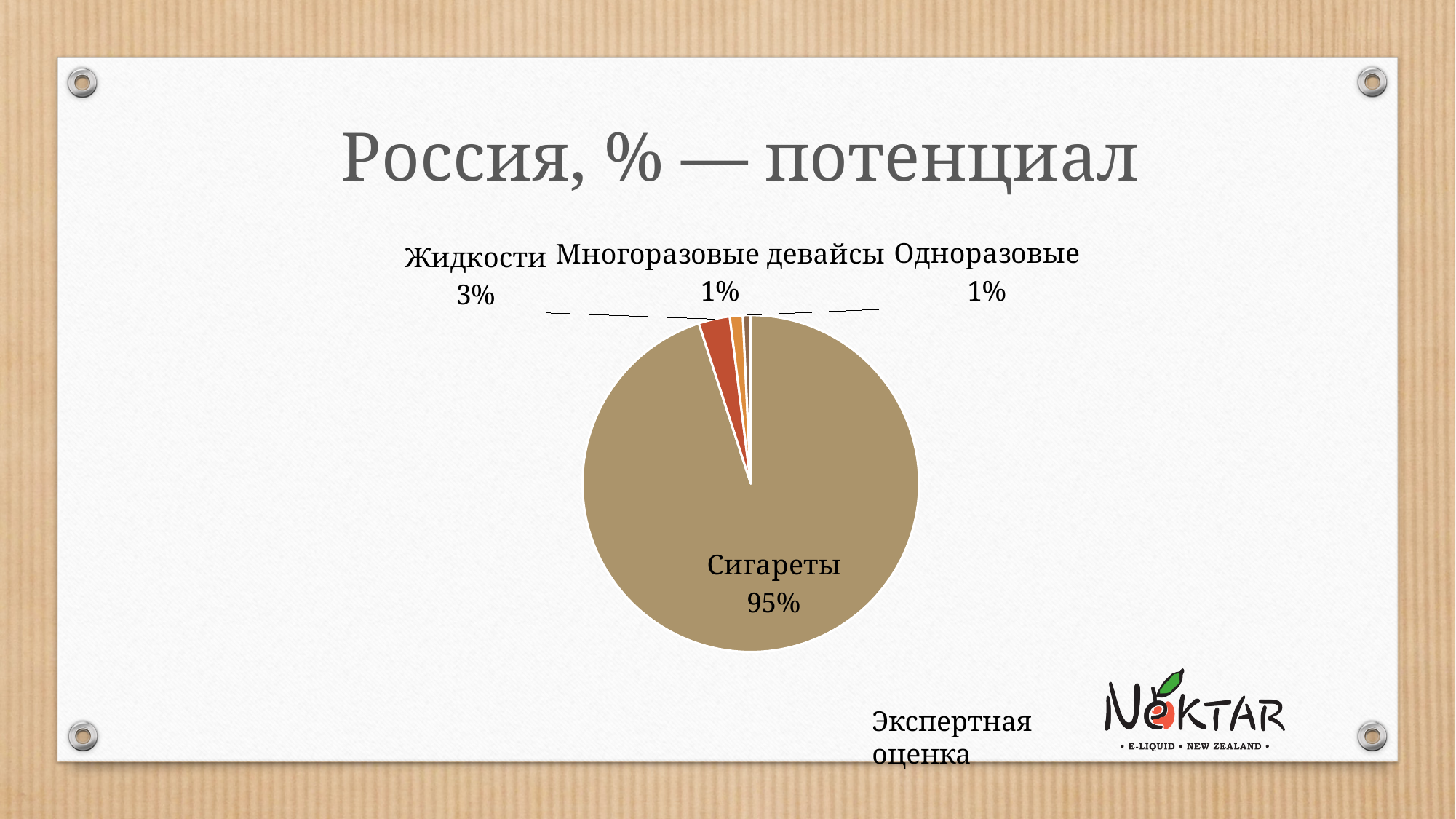
Which is larger, the slice for Жидкости or the slice for Одноразовые? Жидкости What is the combined share of Жидкости, Многоразовые девайсы and Одноразовые? 5% Which category has the largest slice of the pie? Сигареты What share of the pie does Жидкости have? 3% What share of the pie does Сигареты have? 95% What is the difference in percentage points between Сигареты and Жидкости? 92 What type of chart is shown on the slide? pie chart How many slices does the pie chart have? 4 What colour is the Сигареты slice of the pie? tan/brown What is the title of the chart on the slide? Россия, % — потенциал What share of the pie does Одноразовые have? 1% What share of the pie does Многоразовые девайсы have? 1%